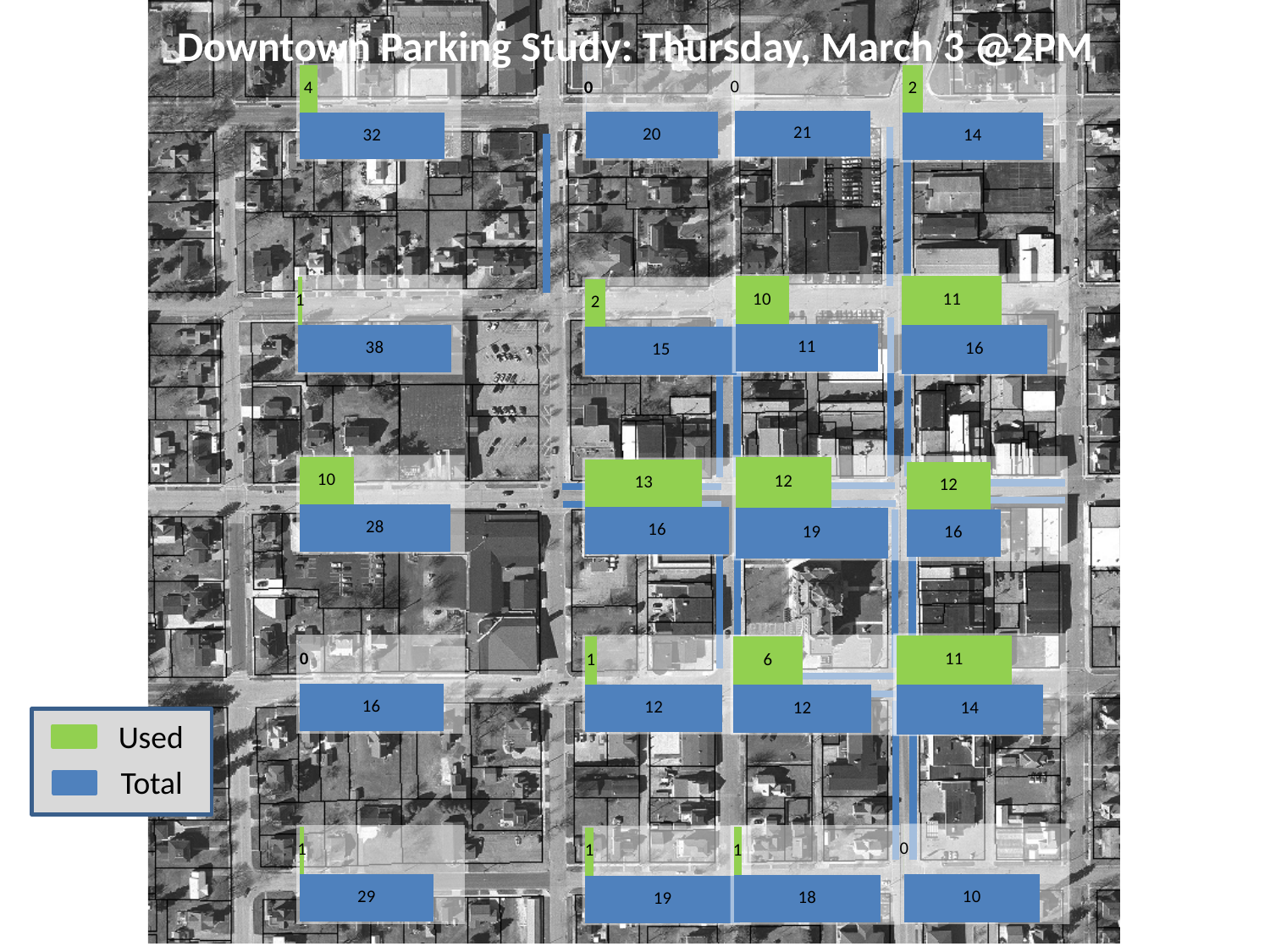
What is the title of the chart on the slide? Downtown Parking Study: Thursday, March 3 @2PM What is the Total value for the block in the top-left corner of the map? 32 How many series does the legend list? 2 For the block in the top-left corner, what is the difference between the Total and Used values? 28 What is the largest Total value shown on the map? 38 Which colour represents the Used series in the legend? Green What is the largest Used value shown on the map? 13 What is the smallest Total value shown on the map? 10 How many blocks on the map have a Total value of 16? 4 What is the Used value for the block in the top-left corner of the map? 4 For the block in the bottom-right corner of the map, what is the Used value? 0 Which is larger for the block in the bottom-right corner of the map, the Used value or the Total value? Total